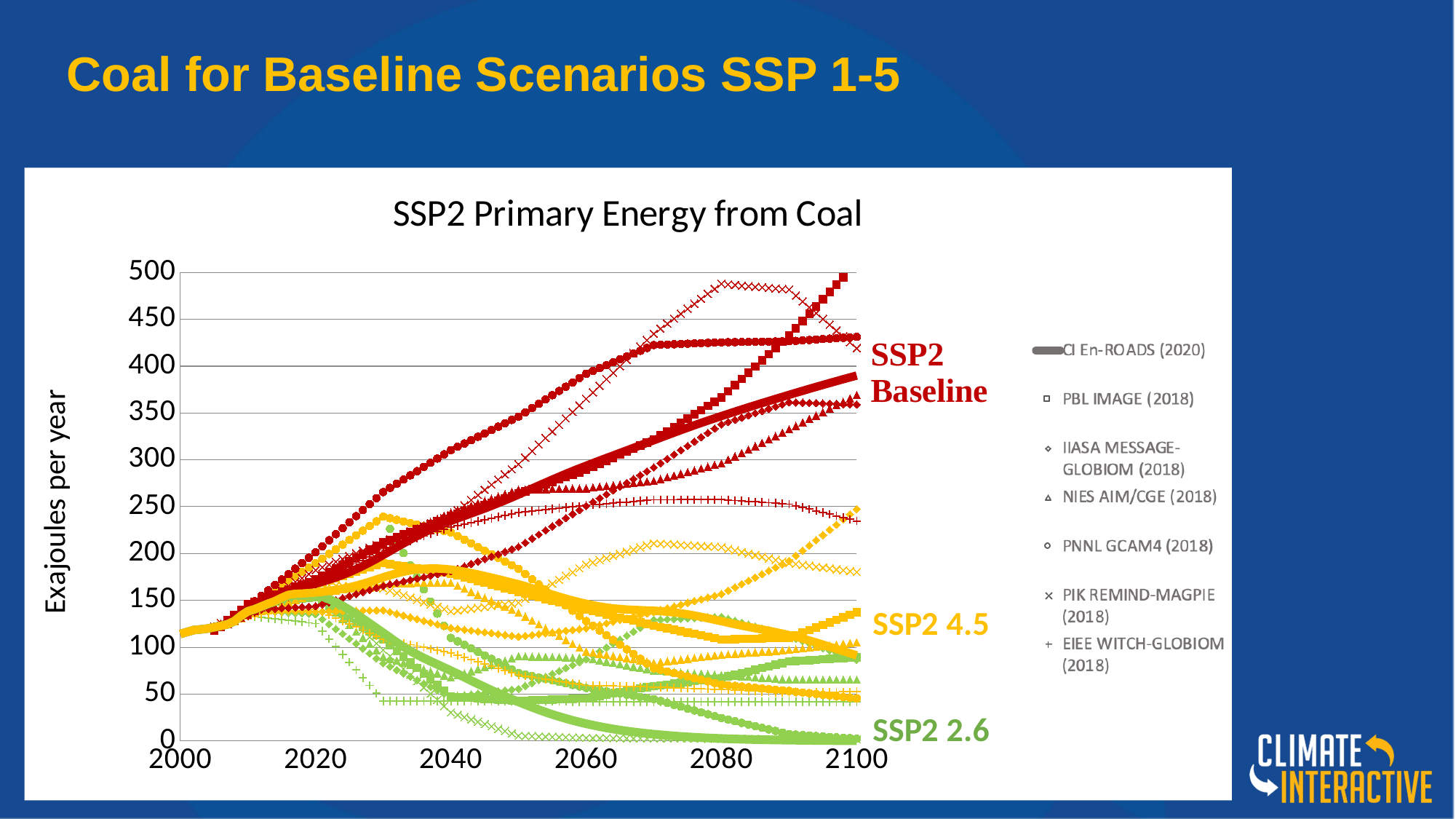
What type of chart is shown on the slide? Line chart Is the value of the thick SSP2 2.6 line in 2100 greater or less than 50? less Is the peak of the PIK REMIND-MAGPIE baseline (red x markers) around 2080 greater or less than 450? greater In 2100, which scenario group has the higher values: SSP2 Baseline or SSP2 2.6? SSP2 Baseline Is the value of the thick SSP2 4.5 line in 2100 greater or less than 150? less Which of the three scenario groups (SSP2 Baseline, SSP2 4.5, SSP2 2.6) has the lowest values in 2100? SSP2 2.6 How many model sources are listed in the chart's legend? 7 Does the thick SSP2 2.6 line rise or fall between 2020 and 2100? fall What is the label on the vertical axis of the chart? Exajoules per year Does the thick SSP2 Baseline line rise or fall between 2020 and 2100? rise What is the title of the chart? SSP2 Primary Energy from Coal